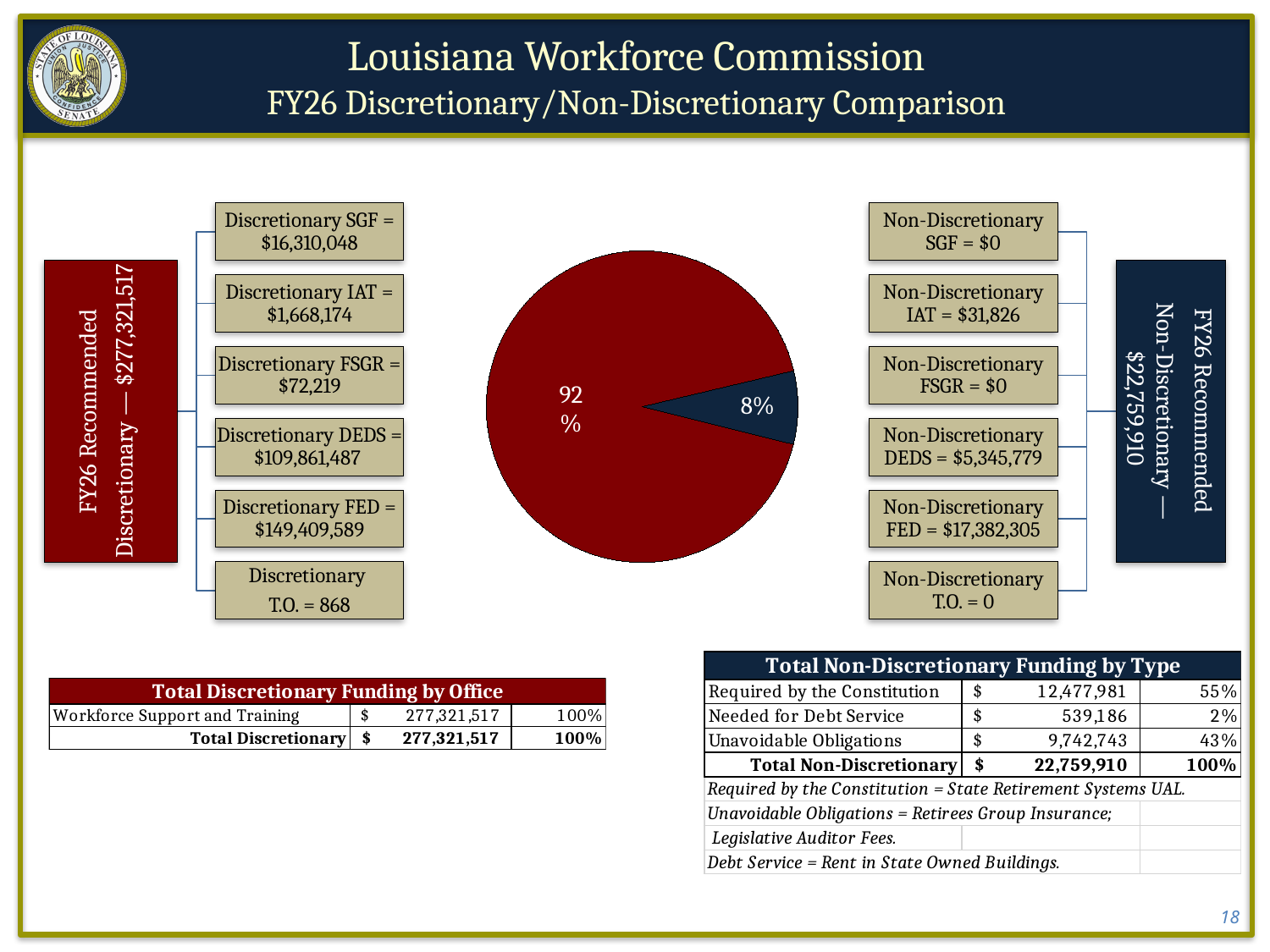
What percentage is shown on the larger (red) slice of the pie chart? 92% Which slice of the pie chart is the smallest, the red one or the dark blue one? the dark blue one What percentage is shown on the smaller (dark blue) slice of the pie chart? 8% Is the value shown on the dark blue slice of the pie chart greater or less than 10%? less What colour is the slice of the pie chart labelled 92%? red Which slice of the pie chart is the largest, the red one or the dark blue one? the red one What kind of chart is shown in the centre of the slide? pie chart What is the difference in percentage points between the two slices of the pie chart? 84 Is the red slice of the pie chart larger or smaller than the dark blue slice? larger What share of the pie chart does the 8% slice represent? 8% Is the value shown on the red slice of the pie chart greater or less than 90%? greater How many slices does the pie chart have? 2